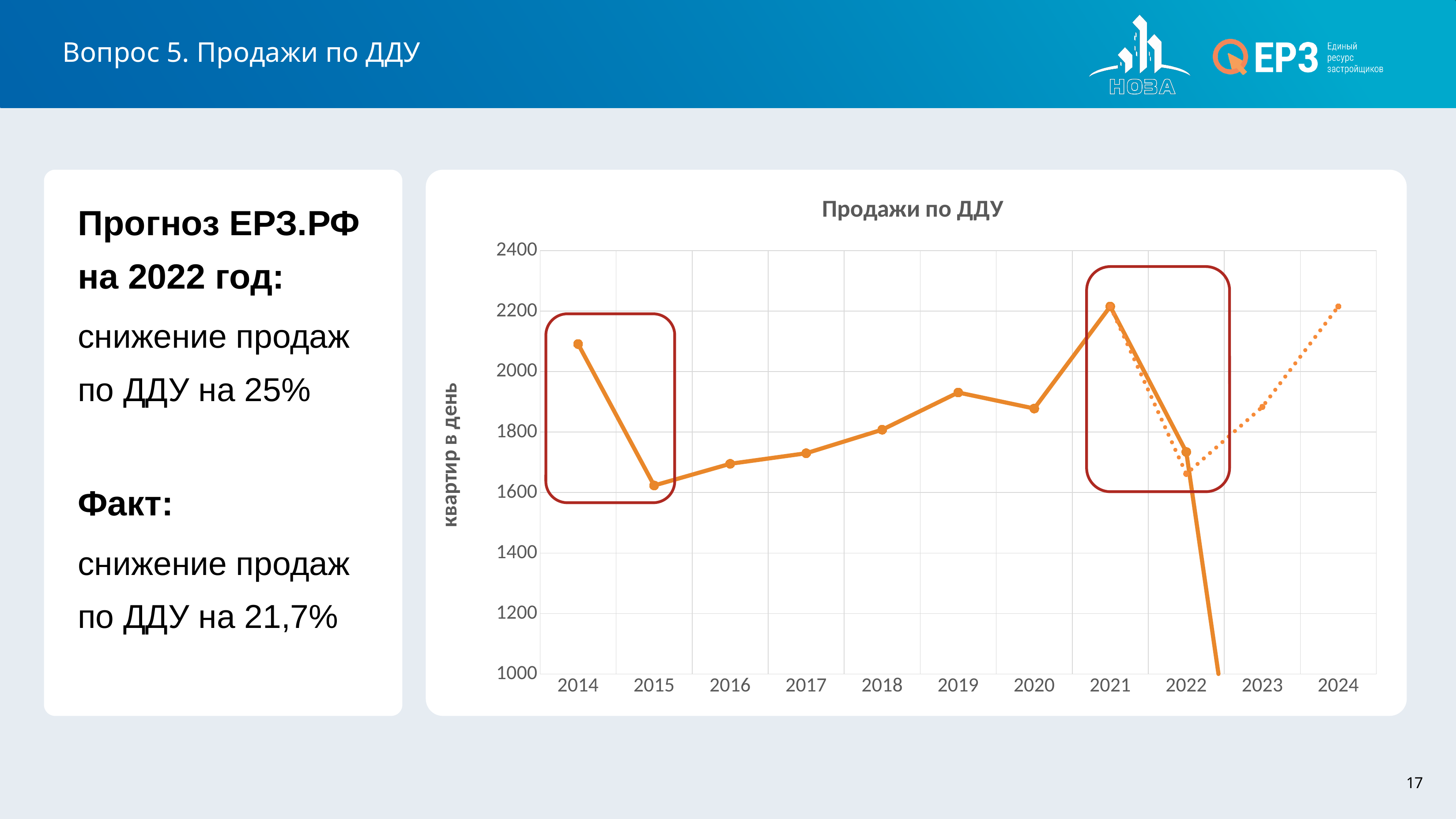
Is the value for 2021 greater or less than 2000? greater Which year has the lowest marked value on the solid line? 2015 Is the value for 2022 greater or less than 1800? less Is the value for 2015 greater or less than 1800? less What kind of chart is shown on the slide? line chart Which year has the highest value on the solid line? 2021 Which year has the larger value, 2019 or 2020? 2019 Do the values rise or fall from 2015 to 2019? rise What is the label of the vertical axis of the chart? квартир в день What is the title of the chart? Продажи по ДДУ How many years are labelled on the x axis of the chart? 11